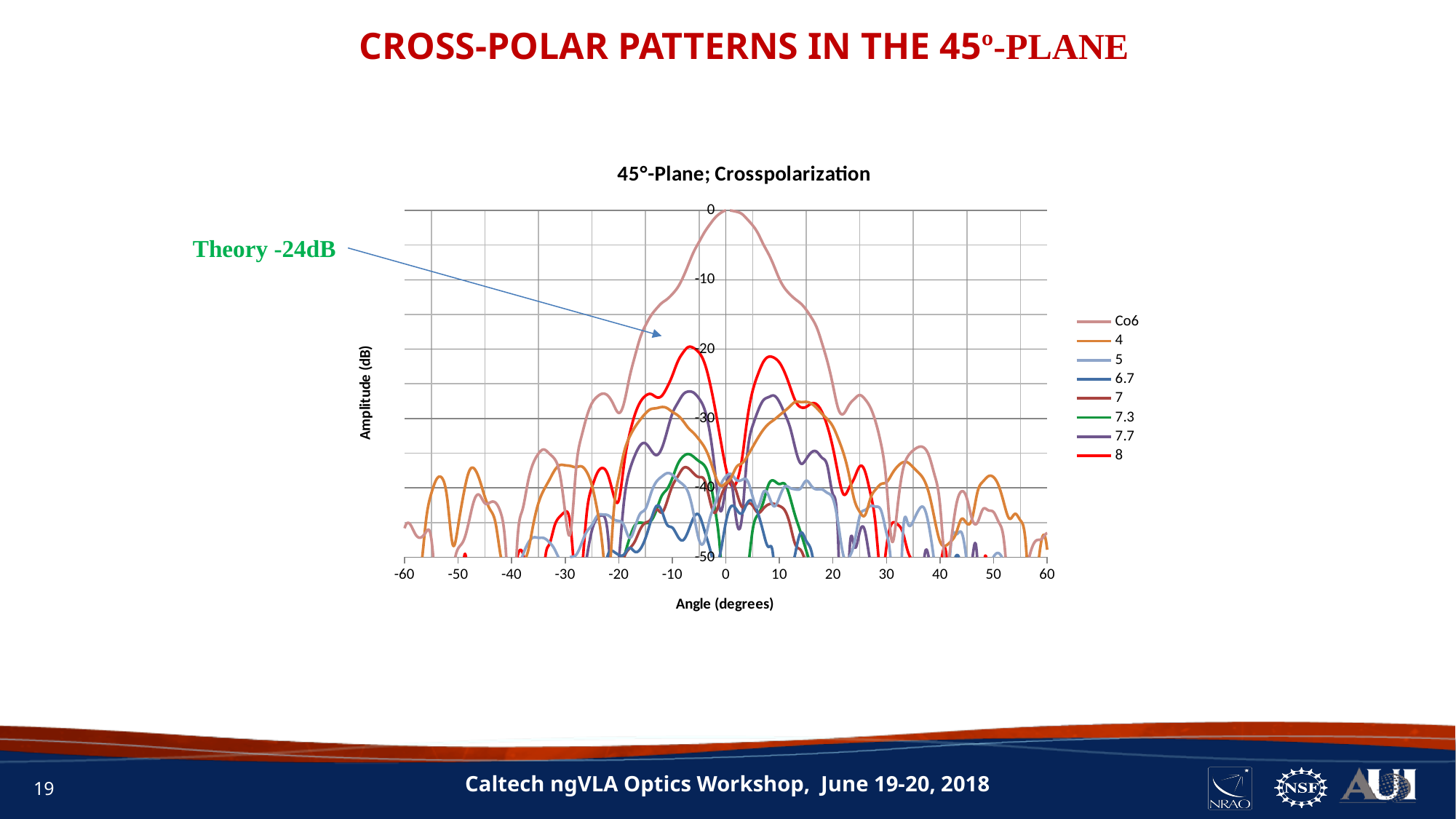
What is the label of the x axis? Angle (degrees) How many tick labels are shown on the x axis? 13 Which series has a higher peak amplitude, 8 or 5? 8 Is the peak amplitude of series 5 greater or less than -30 dB? less Is the peak amplitude of series 8 greater or less than -10 dB? less Is the peak amplitude of series 7.7 greater or less than -30 dB? greater Which series reaches the highest amplitude on the chart? Co6 How many series does the legend list? 8 What is the title of the chart? 45°-Plane; Crosspolarization What kind of chart is shown on the slide? line chart